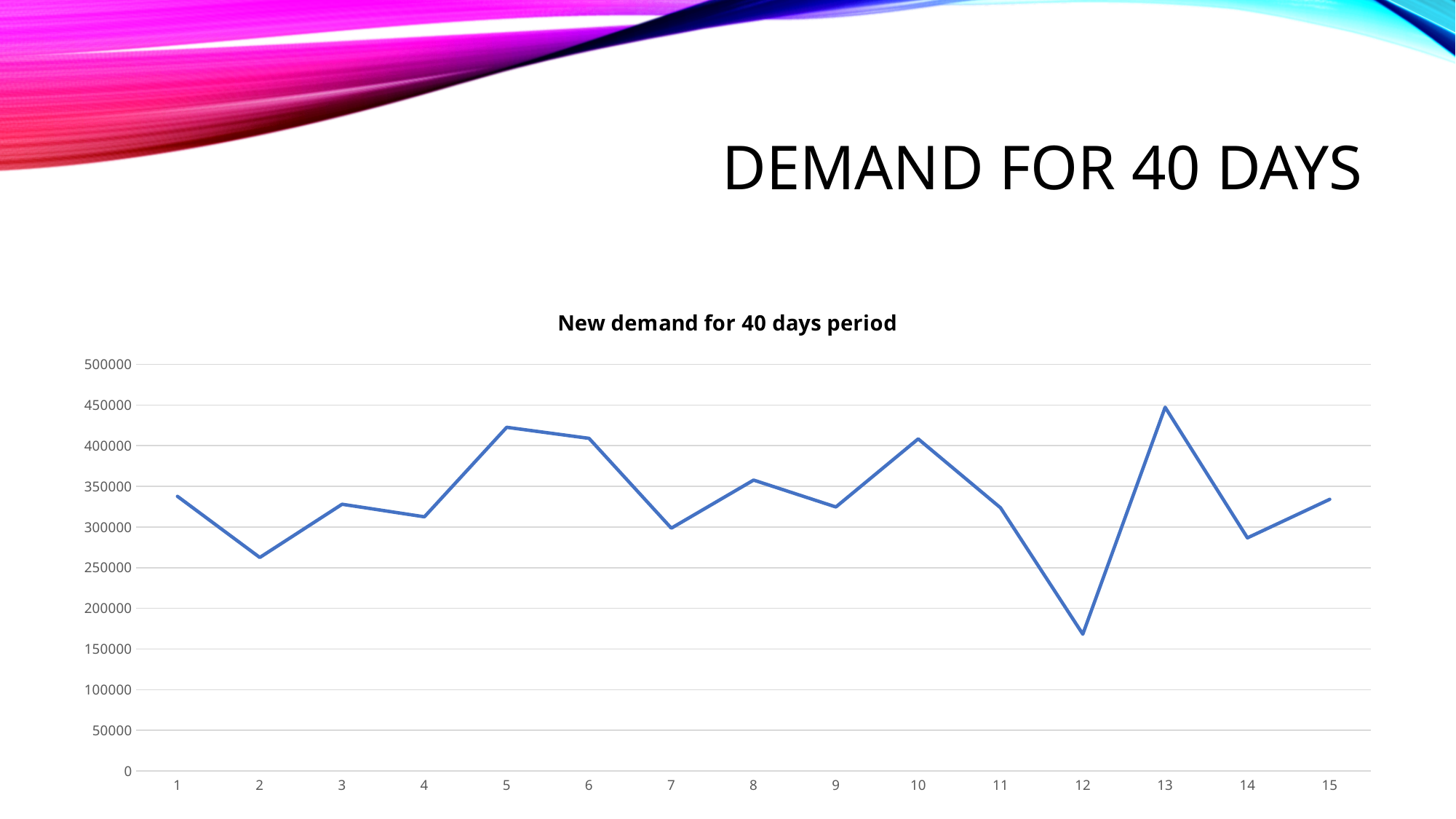
At which x-axis point is the value highest? 13 Which has the larger value, point 5 or point 7? 5 Is the value at point 12 greater or less than 200000? less Does the line rise or fall from point 11 to point 12? fall How many points are plotted along the x axis? 15 At which x-axis point is the value lowest? 12 Is the value at point 13 greater or less than 400000? greater What type of chart is shown on the slide? line chart Is the value at point 2 greater or less than 300000? less What is the title of the chart? New demand for 40 days period Which has the larger value, point 10 or point 14? 10